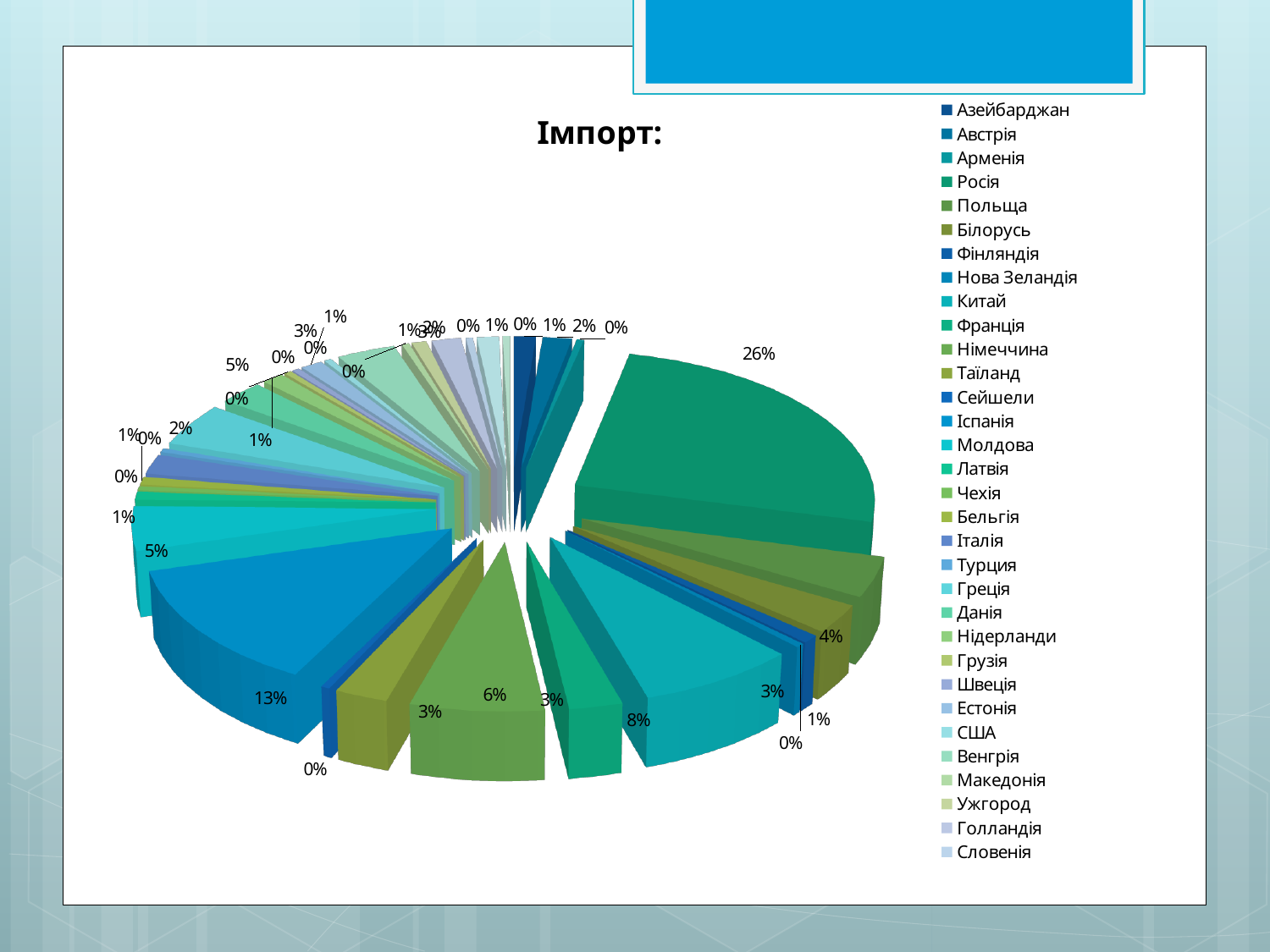
What is the share of the largest slice in the pie chart? 26% What is the title of the chart? Імпорт: What is the difference between the largest slice (26%) and the second-largest slice (13%)? 13 percentage points What is the combined share of the two largest slices (26% and 13%)? 39% What kind of chart is shown on the slide? pie chart What is the share of the second-largest slice in the pie chart? 13% How many entries does the legend of the pie chart list? 32 What is the first entry listed in the legend? Азейбарджан Which is larger: the slice labeled 8% or the slice labeled 6%? the slice labeled 8%